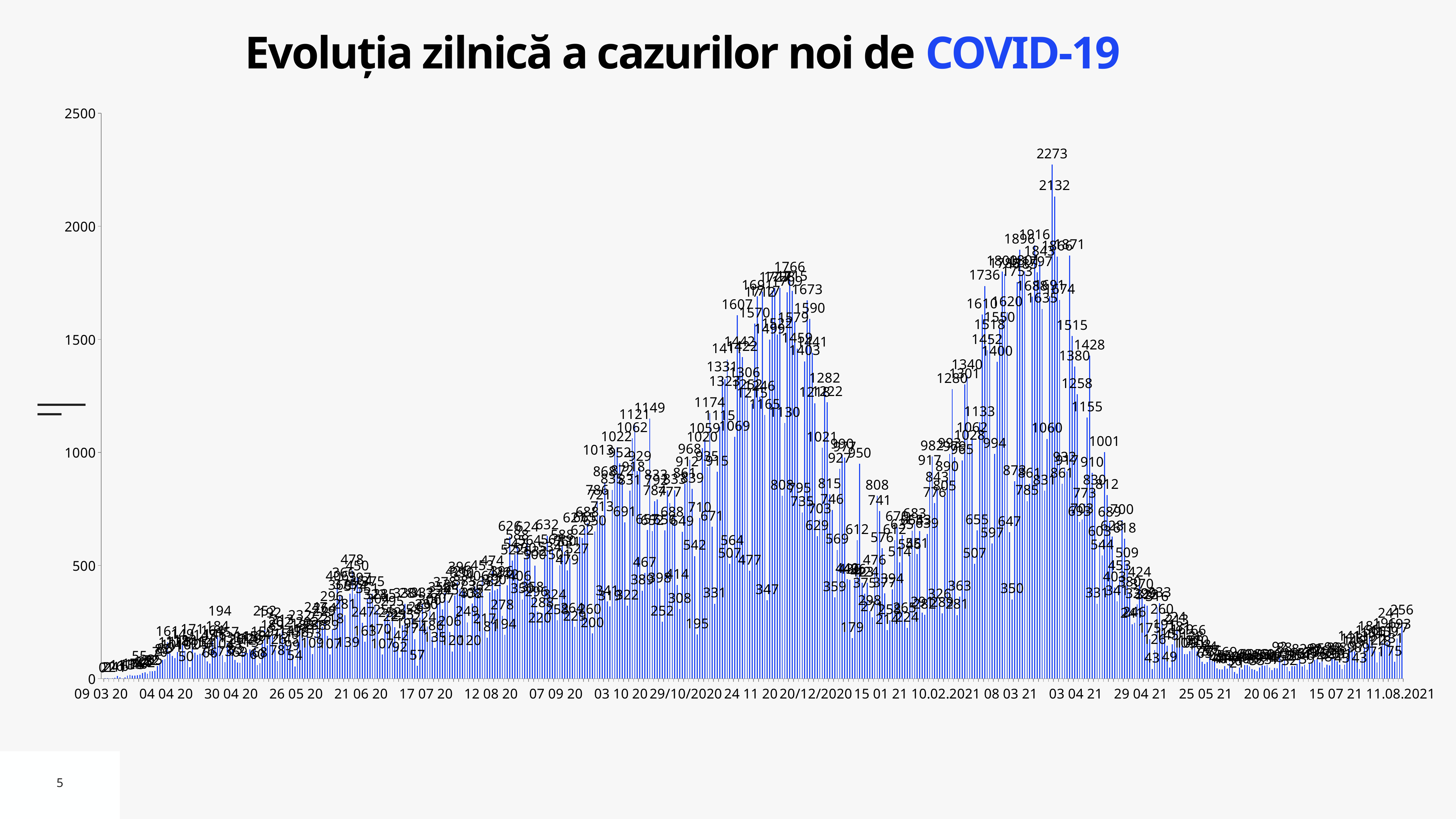
Is the peak of the wave around 24 11 20 greater or less than 2000? less What kind of chart is shown on the slide? bar chart Do the values rise or fall between 09 03 20 and 04 04 20? rise What is the highest value shown on the vertical axis? 2500 What is the title of the chart? Evoluția zilnică a cazurilor noi de COVID-19 How many date labels are shown along the horizontal axis? 21 What is the difference between the two highest labelled values, 2273 and 2132? 141 What is the second-highest data label shown on the chart? 2132 What is the last date label on the horizontal axis? 11.08.2021 Do the values rise or fall between 03 04 21 and 25 05 21? fall Is the highest bar on the chart greater or less than 2000? greater What is the highest daily value labelled on the chart? 2273